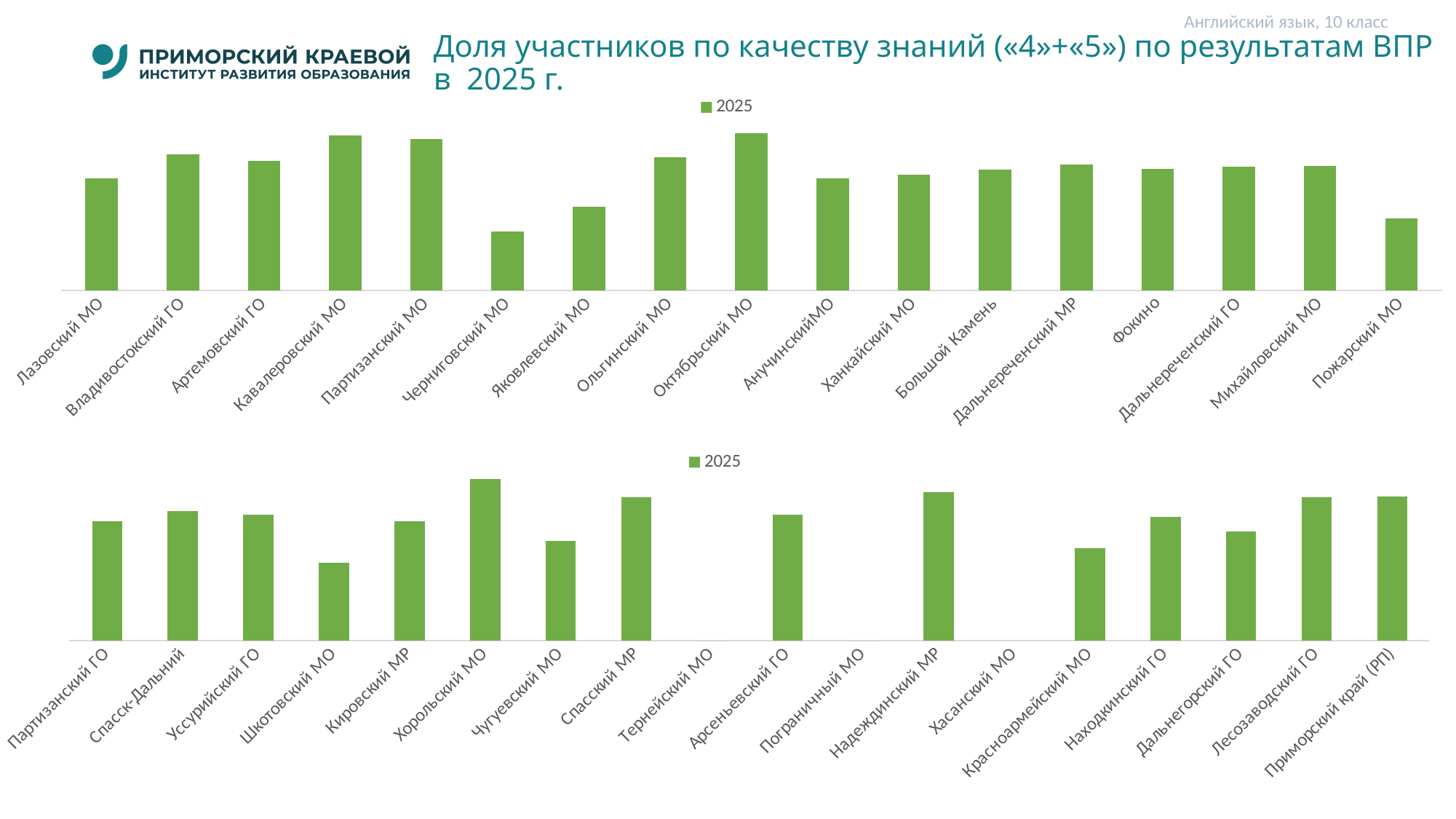
How many series does the legend of the top chart list? 1 In the bottom chart, which category with a visible bar has the lowest value? Шкотовский МО What is the legend entry shown above the bottom chart? 2025 How many categories are shown on the x axis of the top chart? 17 What kind of chart is the top chart on the slide? bar chart In the bottom chart, which is larger: the value for Спасский МР or for Чугуевский МО? Спасский МР In the bottom chart, how many categories have no bar plotted? 3 In the top chart, which category has the lowest bar? Черниговский МО How many categories are shown on the x axis of the bottom chart? 18 In the top chart, which category has the highest bar? Октябрьский МО In the top chart, which is larger: the value for Кавалеровский МО or for Черниговский МО? Кавалеровский МО In the bottom chart, which category has the highest bar? Хорольский МО